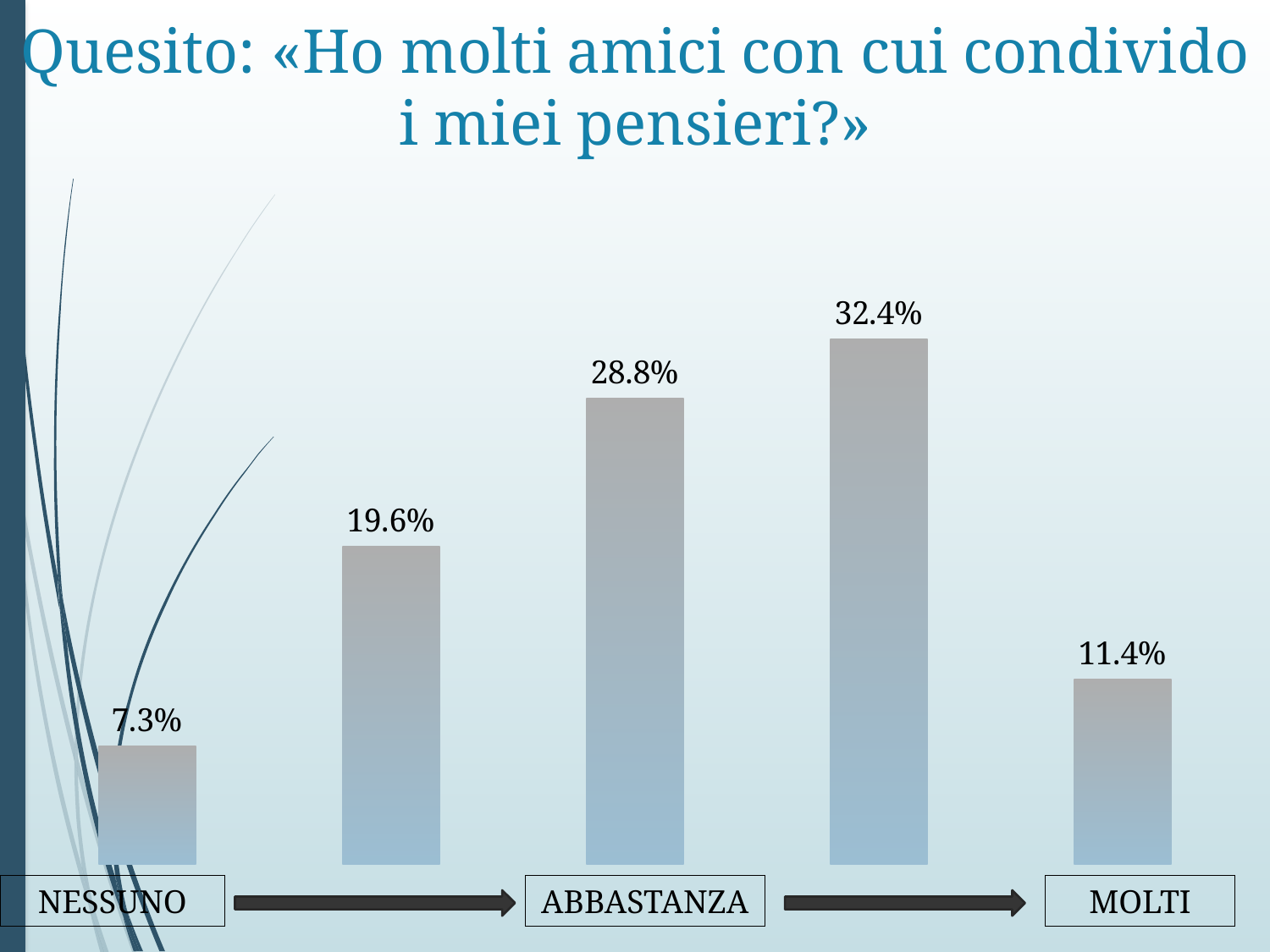
What is the value of the second bar from the left? 19.6% How many bars are plotted in the chart? 5 Which labelled category has the lowest value? NESSUNO What is the value of the bar labelled MOLTI? 11.4% What is the value of the bar labelled NESSUNO? 7.3% What is the value of the bar labelled ABBASTANZA? 28.8% What kind of chart is shown on the slide? bar chart Which is larger, the value for MOLTI or the value for NESSUNO? MOLTI What question is the chart about, according to the slide title? «Ho molti amici con cui condivido i miei pensieri?» What is the value of the fourth bar from the left? 32.4% What is the difference between the values for ABBASTANZA and MOLTI? 17.4% Which bar has the highest value? the fourth bar (32.4%)